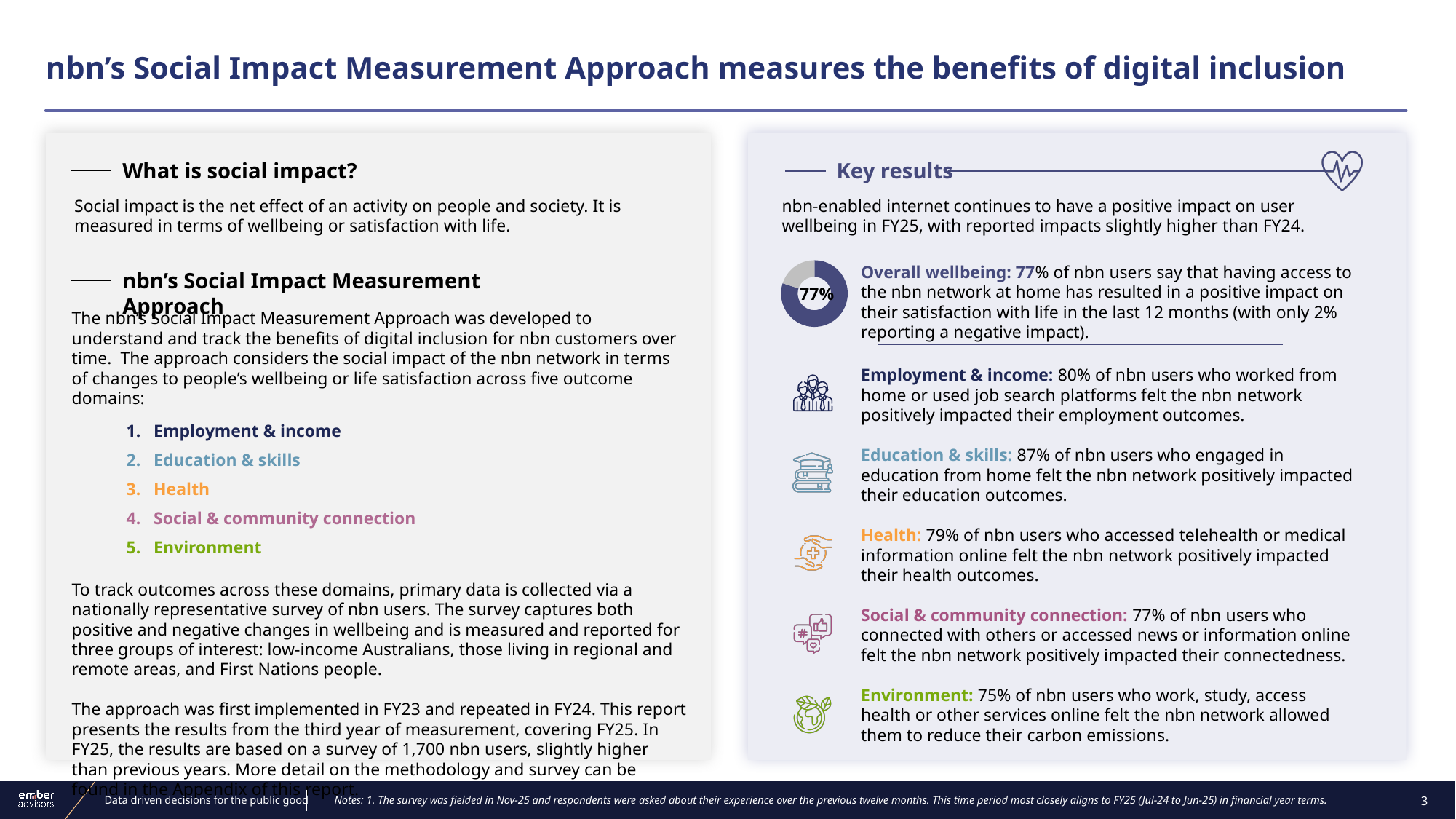
What colour is the highlighted 77% segment of the donut chart? Dark purple How many segments does the donut chart have? 2 What kind of chart is shown next to the Overall wellbeing result? Donut (pie) chart Which key result does the donut chart illustrate? Overall wellbeing Does the highlighted segment of the donut chart represent more or less than half of the whole? More What value is printed in the centre of the donut chart in the Key results panel? 77%